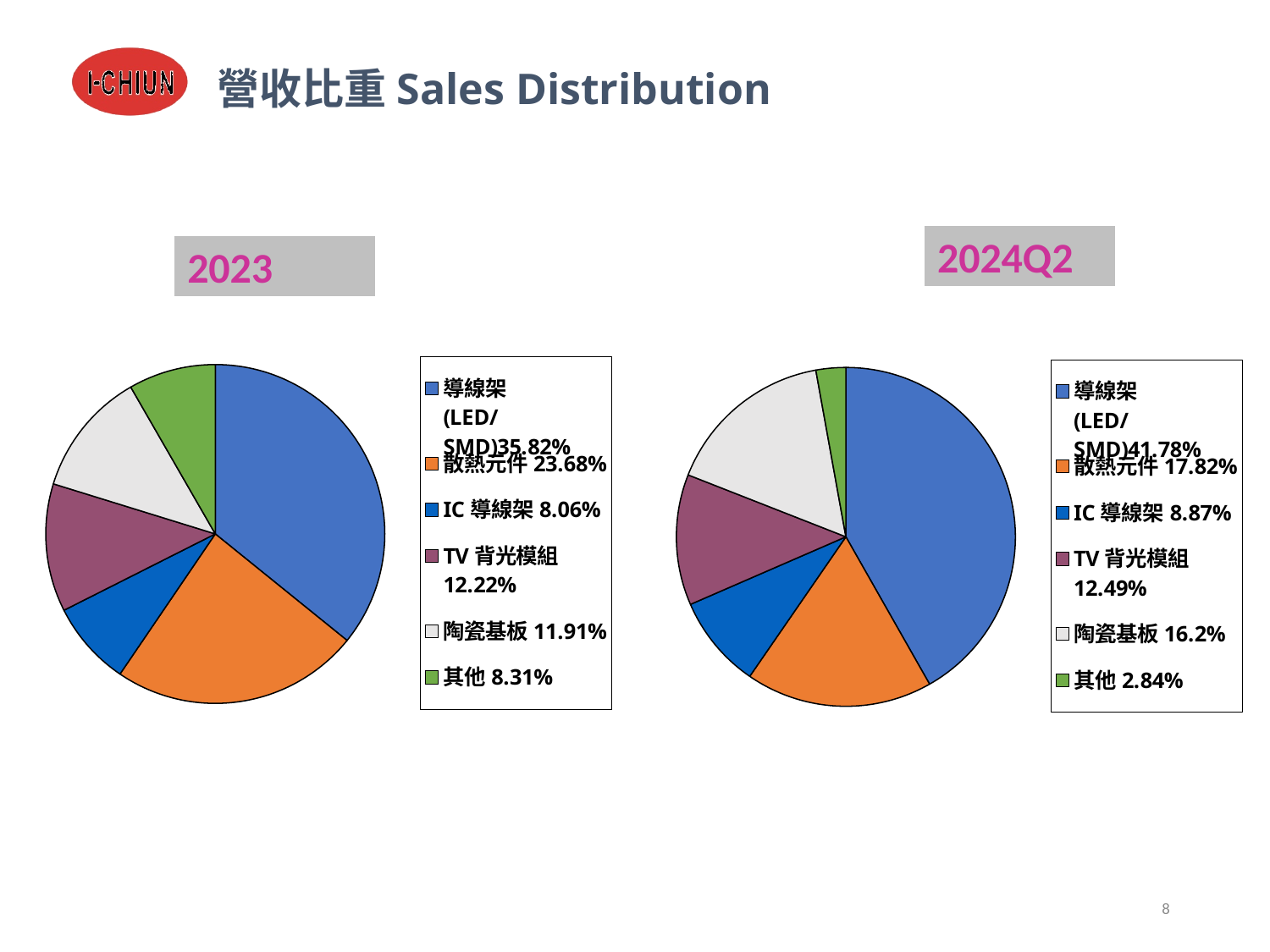
What is the difference between the 導線架 (LED/SMD) share in 2024Q2 and in 2023? 5.96% In the 2023 pie chart, which category has the largest share? 導線架 (LED/SMD) In the 2023 pie chart, which is larger: TV 背光模組 or 陶瓷基板? TV 背光模組 What type of chart is used for the 2024Q2 data? Pie chart In the 2023 pie chart, which category has the smallest share? IC 導線架 In the 2024Q2 pie chart, what share does 其他 have? 2.84% How many categories does the 2023 pie chart show? 6 In the 2024Q2 pie chart, which category has the smallest share? 其他 In the 2023 pie chart, what share does 散熱元件 have? 23.68% In the 2024Q2 pie chart, what share does 陶瓷基板 have? 16.2% What is the title of the slide? 營收比重 Sales Distribution In the 2024Q2 pie chart, which is larger: 散熱元件 or 陶瓷基板? 散熱元件